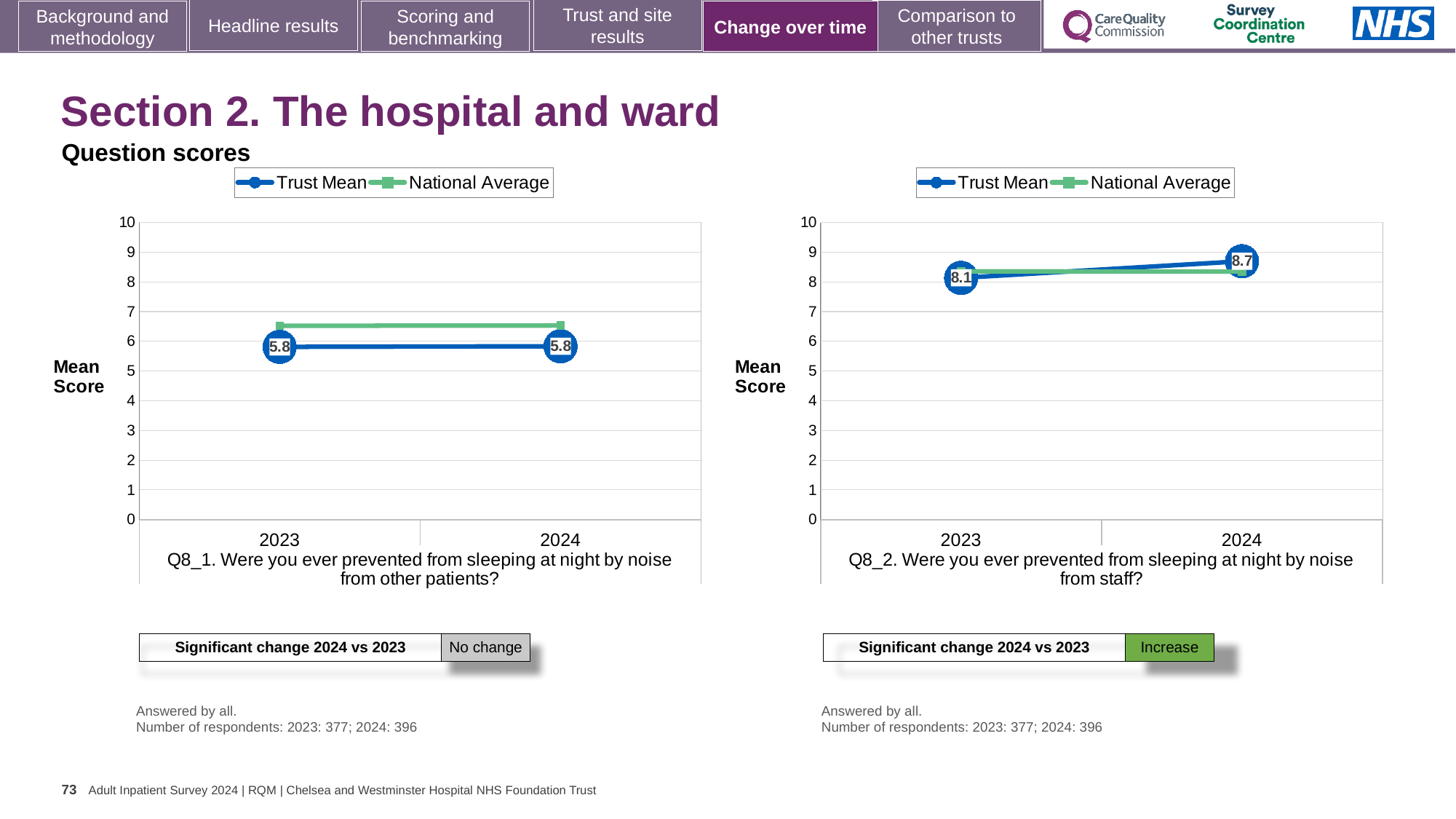
In the Q8_2 chart (right), what is the Trust Mean score for 2023? 8.1 In the Q8_2 chart (right), by how much did the Trust Mean change from 2023 to 2024? 0.6 In the Q8_1 chart (left), is the National Average for 2023 greater or less than 6? greater How many series does the legend of the Q8_2 chart (right) list? 2 What kind of chart is the Q8_1 chart (left)? line chart What significant change result is shown below the Q8_2 chart (right) for 2024 vs 2023? Increase In the Q8_2 chart (right), does the Trust Mean rise or fall from 2023 to 2024? rise In the Q8_1 chart (left), what is the Trust Mean score for 2023? 5.8 In the Q8_2 chart (right), what is the Trust Mean score for 2024? 8.7 In the Q8_1 chart (left), which is higher in 2024, the Trust Mean or the National Average? National Average In the Q8_1 chart (left), what is the Trust Mean score for 2024? 5.8 How many years are plotted on the x axis of the Q8_1 chart (left)? 2